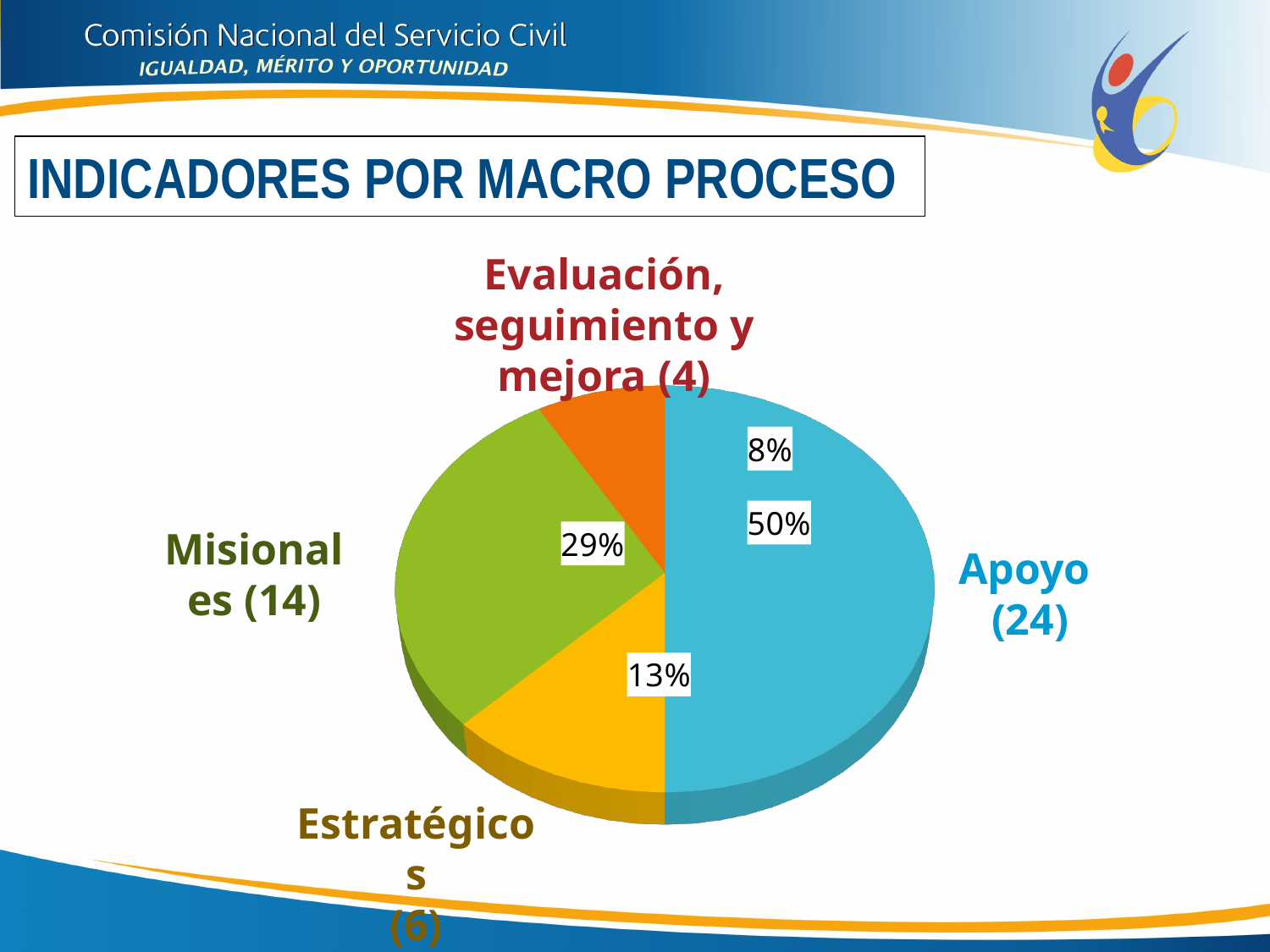
What percentage of the pie does the Estratégicos slice represent? 13% What type of chart is shown on the slide? Pie chart What percentage of the pie does the Evaluación, seguimiento y mejora slice represent? 8% Which has more indicators, Estratégicos or Evaluación, seguimiento y mejora? Estratégicos How many indicators are shown for Apoyo? 24 How many indicators are shown for Misionales? 14 Which macro process has the smallest slice of the pie? Evaluación, seguimiento y mejora What percentage of the pie does the Misionales slice represent? 29% How many slices does the pie chart have? 4 Which macro process has the largest slice of the pie? Apoyo What is the difference in the number of indicators between Apoyo and Misionales? 10